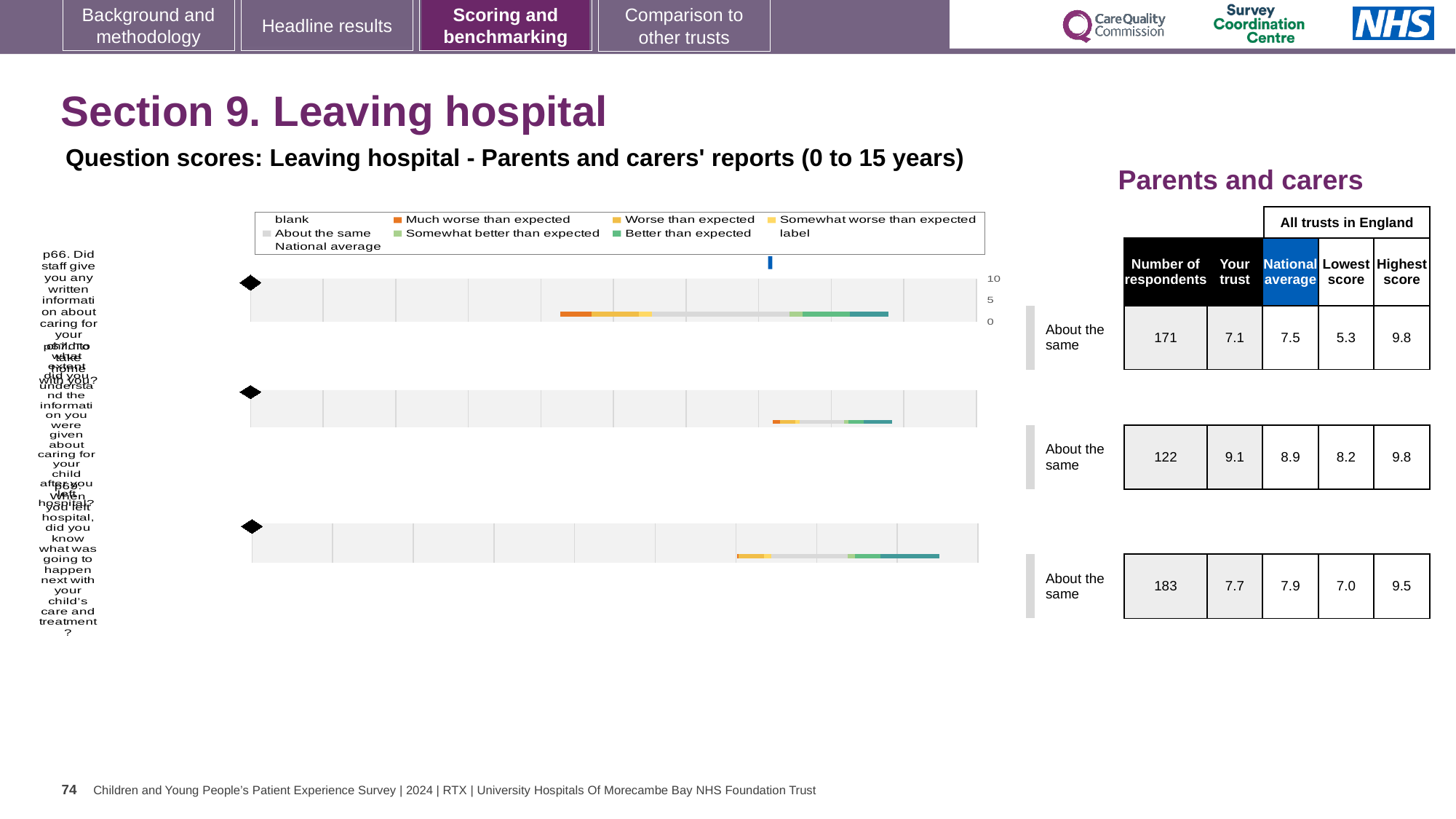
In the table beside the charts, what is the 'Your trust' score for the first row (p66)? 7.1 What benchmark category is shown next to the first question score chart (p66)? About the same In the table beside the charts, what is the difference between the highest score and the lowest score for the first row (p66)? 4.5 In the chart legend, which colour represents 'Much worse than expected'? orange What is the maximum value shown on the score axis of the question score charts? 10 In the table beside the charts, is the 'Your trust' score for the second row larger or smaller than its national average? larger In the table beside the charts, how many respondents are listed for the third row (p68)? 183 How many question score charts are shown on the slide? 3 What kind of chart is used to show the question scores on this slide? bar chart What benchmark category is shown next to the third question score chart (p68)? About the same In the table beside the charts, which row has the highest 'Your trust' score? the second row (9.1) In the table beside the charts, what is the national average for the third row (p68)? 7.9